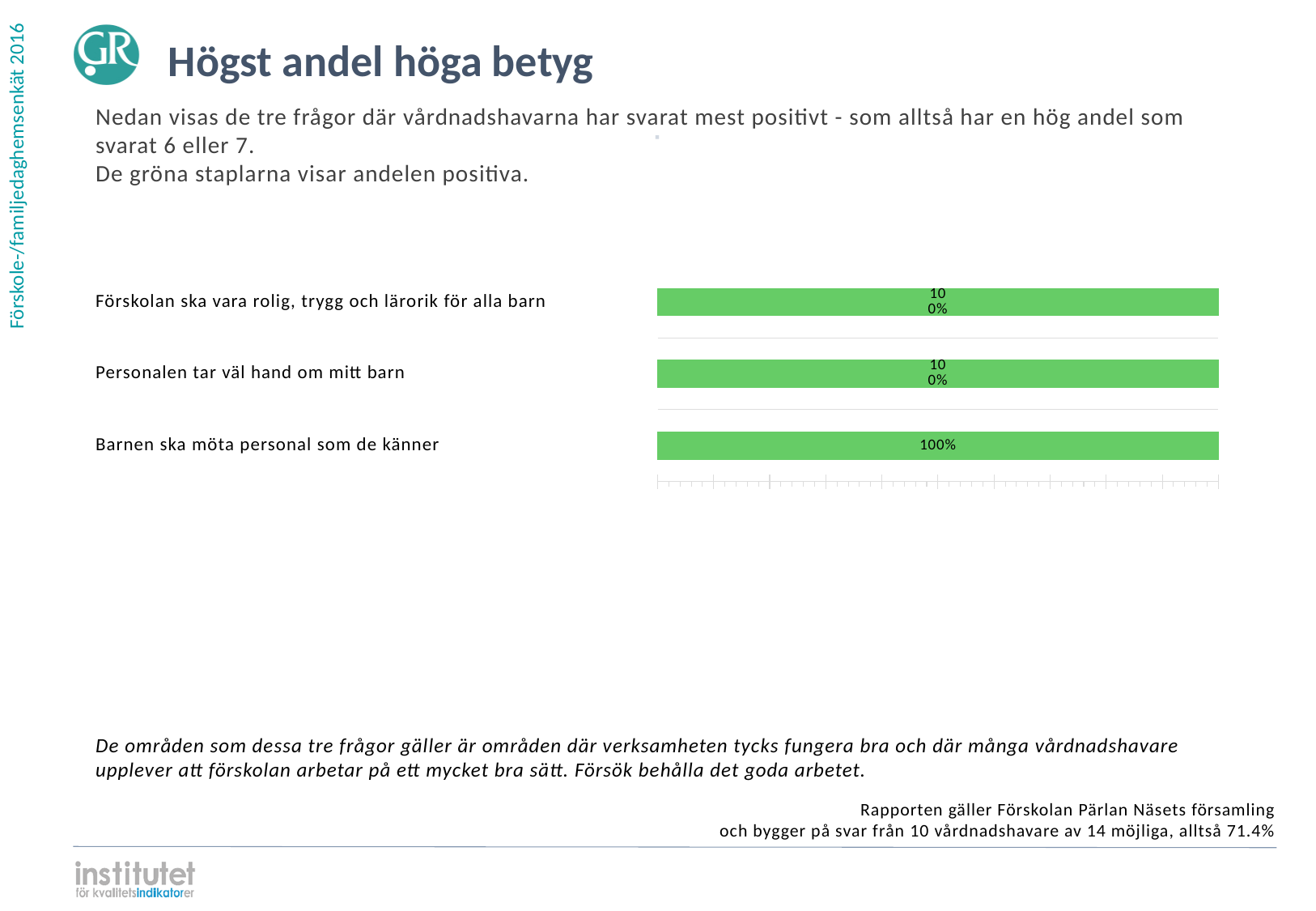
What colour are the bars in the chart? green How many categories are shown in the chart? 3 What is the title of the slide containing the chart? Högst andel höga betyg What kind of chart is shown on the slide? bar chart What is the difference between the values for "Personalen tar väl hand om mitt barn" and "Barnen ska möta personal som de känner"? 0% Which category is listed at the bottom of the chart? Barnen ska möta personal som de känner What is the value for "Förskolan ska vara rolig, trygg och lärorik för alla barn"? 100% What is the value for "Personalen tar väl hand om mitt barn"? 100% What is the value for "Barnen ska möta personal som de känner"? 100%